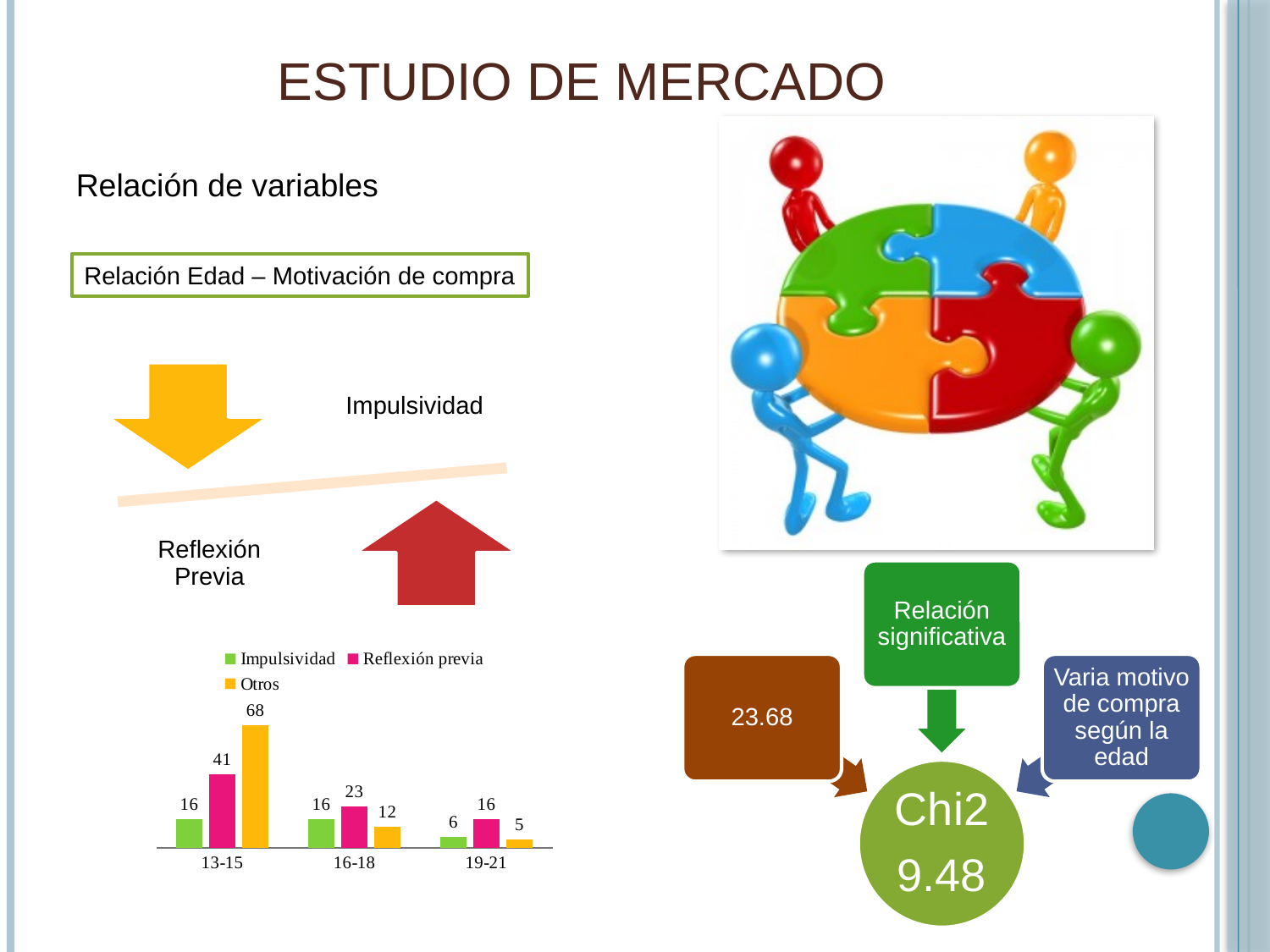
Which is larger in the 16-18 age group, Reflexión previa or Otros? Reflexión previa What is the value for Reflexión previa in the 16-18 age group? 23 What is the value for Impulsividad in the 19-21 age group? 6 What is the difference between Otros and Reflexión previa in the 13-15 age group? 27 What kind of chart is shown on the slide? Bar chart Which colour represents Reflexión previa in the chart legend? Pink How many series does the chart legend list? 3 Which age group has the lowest value for Reflexión previa? 19-21 Which age group has the highest value for Otros? 13-15 How many age groups are shown on the x axis of the chart? 3 What is the value for Otros in the 13-15 age group? 68 Does the value for Otros rise or fall from the 13-15 group to the 19-21 group? Fall